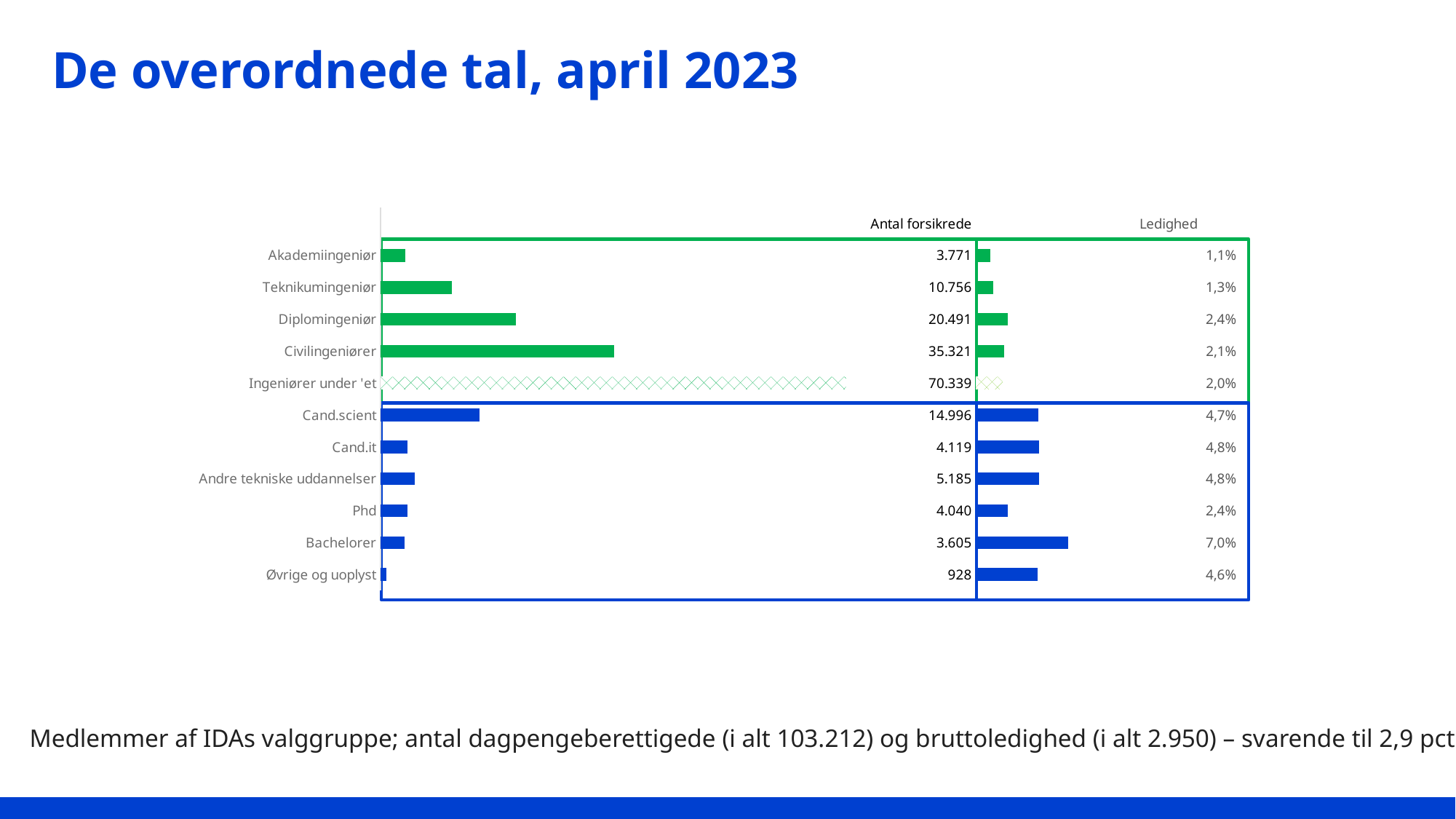
What is the Antal forsikrede value for Ingeniører under 'et? 70.339 What is the difference in Antal forsikrede between Civilingeniører and Diplomingeniør? 14.830 What is the Antal forsikrede value for Civilingeniører? 35.321 How many series does the chart show? 2 Which category has the highest Ledighed value? Bachelorer Which category has the lowest Ledighed value? Akademiingeniør What kind of chart is shown on the slide? Bar chart Which category has the lowest Antal forsikrede value? Øvrige og uoplyst What is the Ledighed value for Bachelorer? 7,0% What is the Ledighed value for Cand.scient? 4,7% Which has a higher Ledighed value, Phd or Cand.it? Cand.it How many categories are shown in the chart? 11